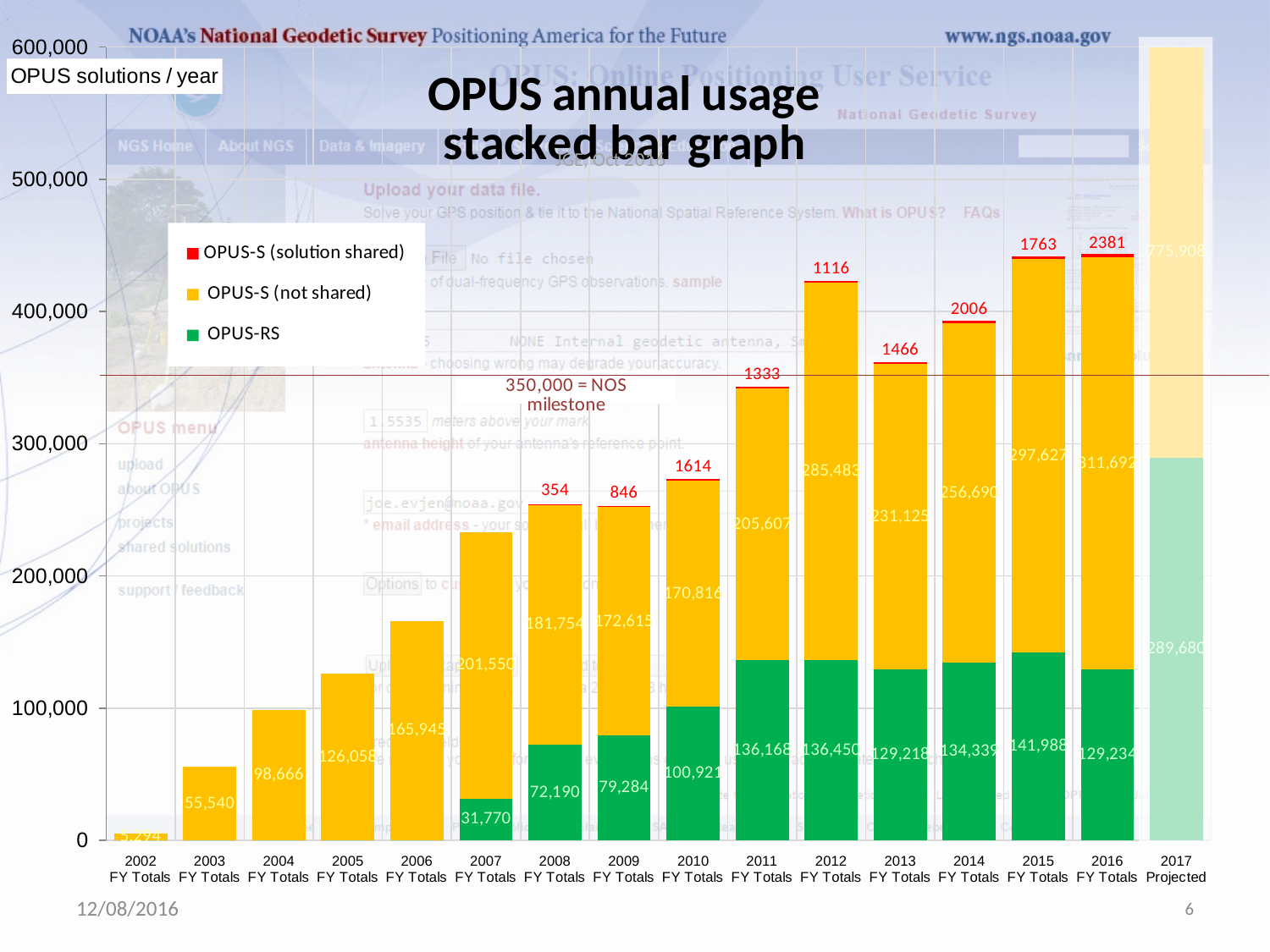
How many series does the legend list? 3 What is the total of the stacked bar for 2008 FY Totals? 254,298 Is the total of the stacked bar for 2006 FY Totals greater or less than 200,000? less What is the OPUS-RS value for 2010 FY Totals? 100,921 Which year has the highest OPUS-S (solution shared) value? 2016 FY Totals How many categories are shown on the x axis? 16 What is the OPUS-S (not shared) value for 2016 FY Totals? 311,692 Which year has the lowest OPUS-S (solution shared) value? 2008 FY Totals What is the OPUS-S (solution shared) value for 2014 FY Totals? 2006 Which is larger, the OPUS-S (not shared) value for 2012 FY Totals or for 2013 FY Totals? 2012 FY Totals What kind of chart is shown on the slide? Stacked bar chart What is the difference between the OPUS-RS values for 2015 FY Totals and 2014 FY Totals? 7,649